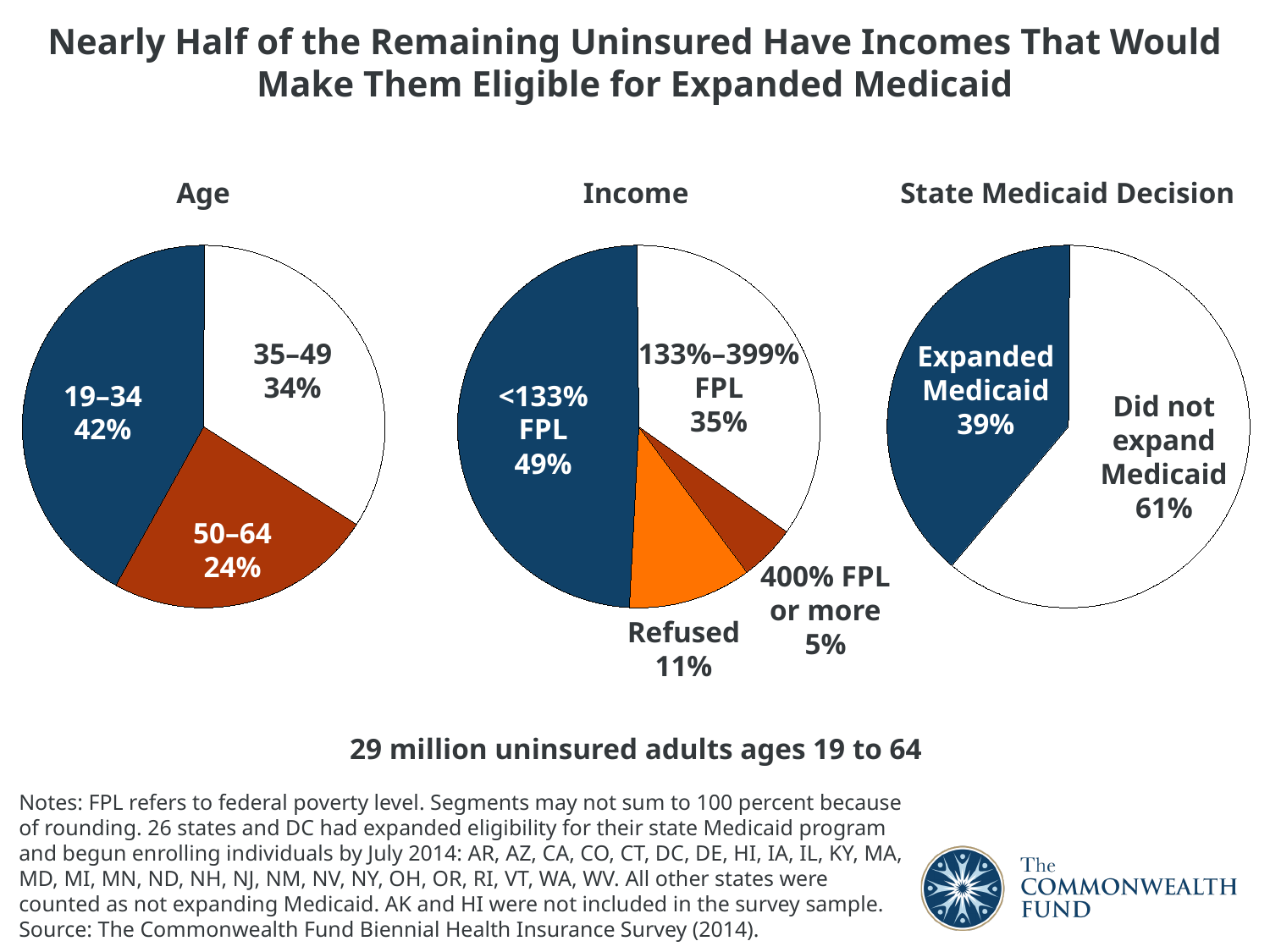
In the State Medicaid Decision pie chart, which slice is larger: Expanded Medicaid or Did not expand Medicaid? Did not expand Medicaid In the Income pie chart, which category has the smallest share? 400% FPL or more In the Income pie chart, what share of the remaining uninsured have incomes below 133% FPL? 49% In the State Medicaid Decision pie chart, what share of the remaining uninsured live in states that did not expand Medicaid? 61% In the Income pie chart, which income category has the largest share? <133% FPL In the Age pie chart, which age group has the smallest share? 50–64 In the Income pie chart, how many slices are there? 4 In the Income pie chart, what share of respondents refused to give their income? 11% How many pie charts are shown on the slide? 3 In the Age pie chart, what is the difference in percentage points between the 19–34 and 50–64 slices? 18 percentage points What type of chart is used for the Age, Income, and State Medicaid Decision breakdowns? Pie chart In the Age pie chart, what share of the remaining uninsured are ages 19–34? 42%